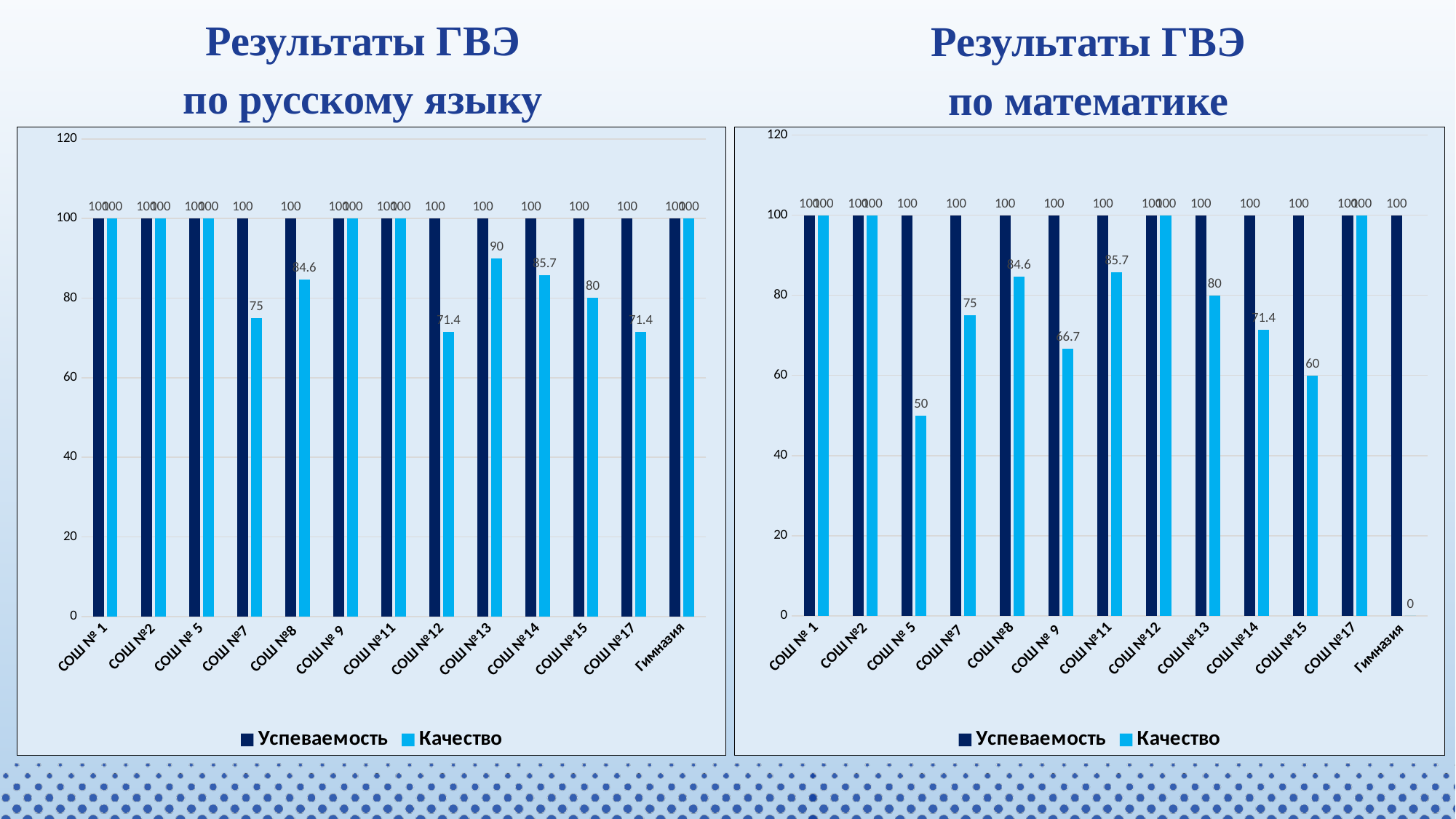
In the chart 'Результаты ГВЭ по математике', what is the Качество value for Гимназия? 0 What are the two legend entries in the chart 'Результаты ГВЭ по математике'? Успеваемость and Качество What type of chart is 'Результаты ГВЭ по русскому языку'? Bar chart In the chart 'Результаты ГВЭ по русскому языку', what is the difference between the Качество values for СОШ №13 and СОШ №12? 18.6 How many series does the legend of the chart 'Результаты ГВЭ по математике' list? 2 In the chart 'Результаты ГВЭ по математике', what is the Качество value for СОШ № 5? 50 In the chart 'Результаты ГВЭ по русскому языку', what is the Качество value for СОШ №13? 90 How many schools (categories) are shown on the x axis of the chart 'Результаты ГВЭ по русскому языку'? 13 In the chart 'Результаты ГВЭ по математике', which is larger: the Качество value for СОШ №8 or for СОШ № 9? СОШ №8 In the chart 'Результаты ГВЭ по русскому языку', what is the Качество value for СОШ №7? 75 In the chart 'Результаты ГВЭ по математике', is the Качество value for СОШ №15 greater or less than 80? less In the chart 'Результаты ГВЭ по математике', which school has the lowest Качество value? Гимназия